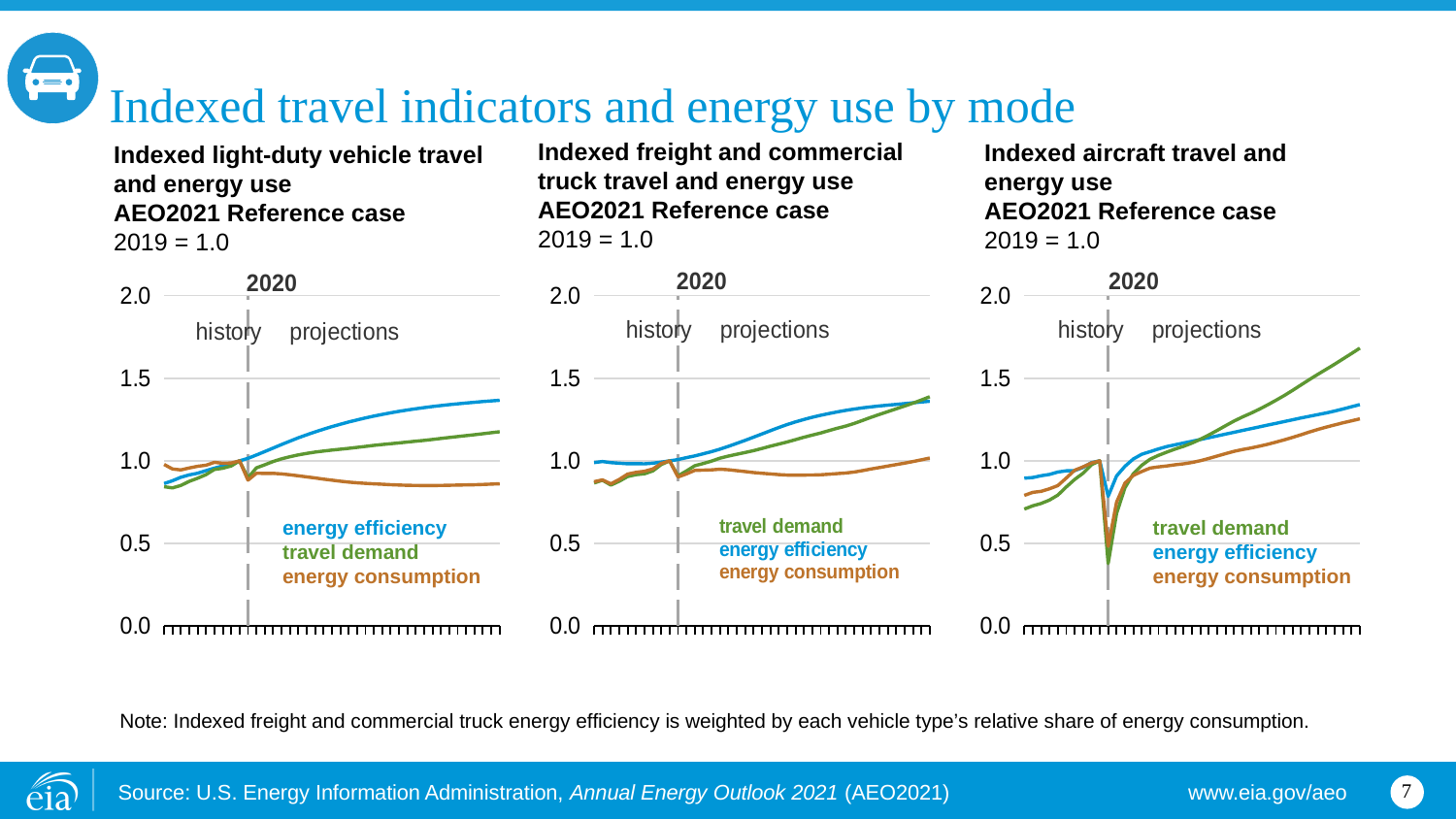
In the 'Indexed light-duty vehicle travel and energy use' chart, is the value for energy efficiency at the end of the projection period greater or less than 1.0? greater In the 'Indexed light-duty vehicle travel and energy use' chart, does energy consumption rise or fall over the projection period? fall How many series are shown in the 'Indexed aircraft travel and energy use' chart? 3 In the 'Indexed light-duty vehicle travel and energy use' chart, which series is highest at the end of the projection period? energy efficiency In the 'Indexed aircraft travel and energy use' chart, which series is highest at the end of the projection period? travel demand Which year marks the boundary between history and projections in the charts? 2020 What kind of chart is the 'Indexed light-duty vehicle travel and energy use' chart? line chart In the 'Indexed aircraft travel and energy use' chart, is the value for travel demand at the end of the projection period greater or less than 1.5? greater In the 'Indexed freight and commercial truck travel and energy use' chart, does travel demand rise or fall over the projection period? rise In the 'Indexed light-duty vehicle travel and energy use' chart, is the value for energy consumption at the end of the projection period greater or less than 1.0? less